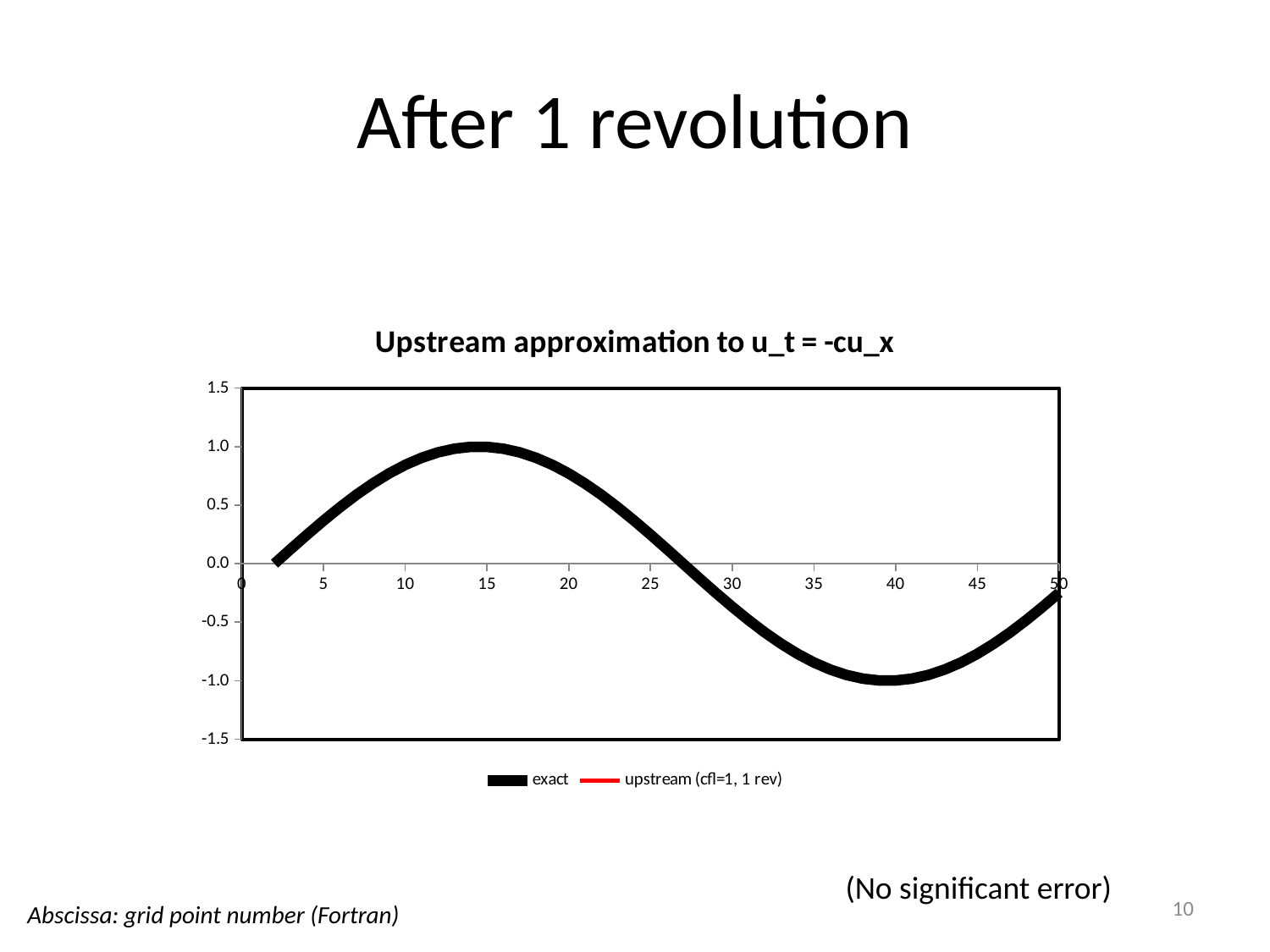
Near which x-axis tick does the curve reach its lowest value? 40 Is the value of the curve at x = 35 greater or less than 0.0? less Is the value of the curve at x = 15 greater or less than 0.5? greater Between x = 15 and x = 40, do the values rise or fall along the x axis? fall Is the value of the curve at x = 15 larger or smaller than the value at x = 40? larger What kind of chart is shown on the slide? line chart Is the value of the curve at x = 5 greater or less than 0.0? greater How many series does the chart legend list? 2 What is the title of the chart? Upstream approximation to u_t = -cu_x Near which x-axis tick does the curve reach its highest value? 15 What are the two series named in the legend? exact; upstream (cfl=1, 1 rev)